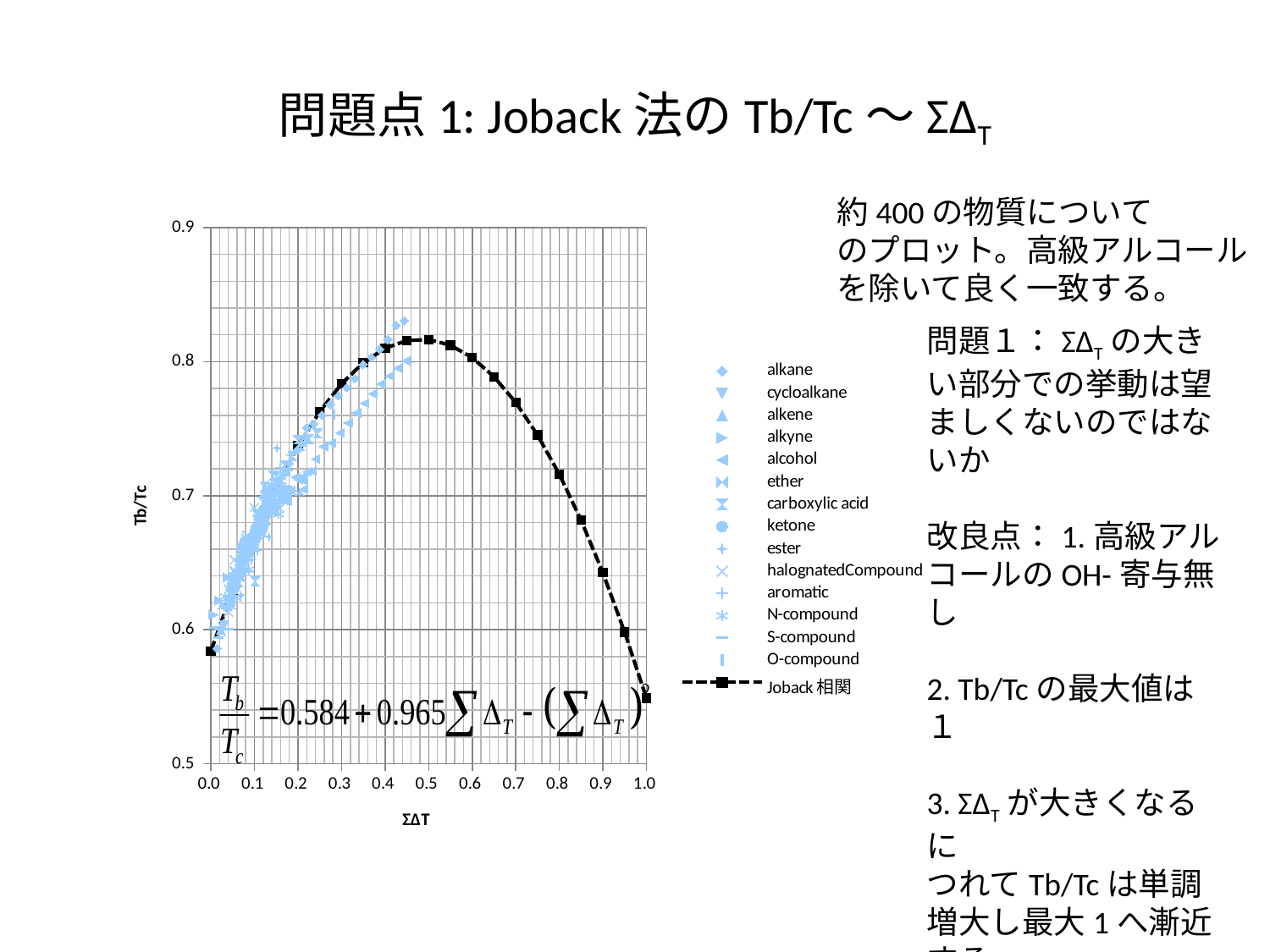
What is the label of the x axis of the chart? ΣΔT Is the value of the Joback 相関 series at ΣΔT = 1.0 greater or less than 0.6? less Is the value of the Joback 相関 series at ΣΔT = 0.8 greater or less than 0.7? greater What is the label of the y axis of the chart? Tb/Tc What is the maximum value shown on the y axis of the chart? 0.9 Is the value of the Joback 相関 series at ΣΔT = 0.5 greater or less than 0.8? greater What kind of chart is shown on the slide? scatter chart Does the Joback 相関 series rise or fall as ΣΔT increases from 0.6 to 1.0? fall Does the Joback 相関 series rise or fall as ΣΔT increases from 0.0 to 0.4? rise Which is larger for the Joback 相関 series: the value at ΣΔT = 0.5 or the value at ΣΔT = 1.0? ΣΔT = 0.5 How many series does the chart legend list? 15